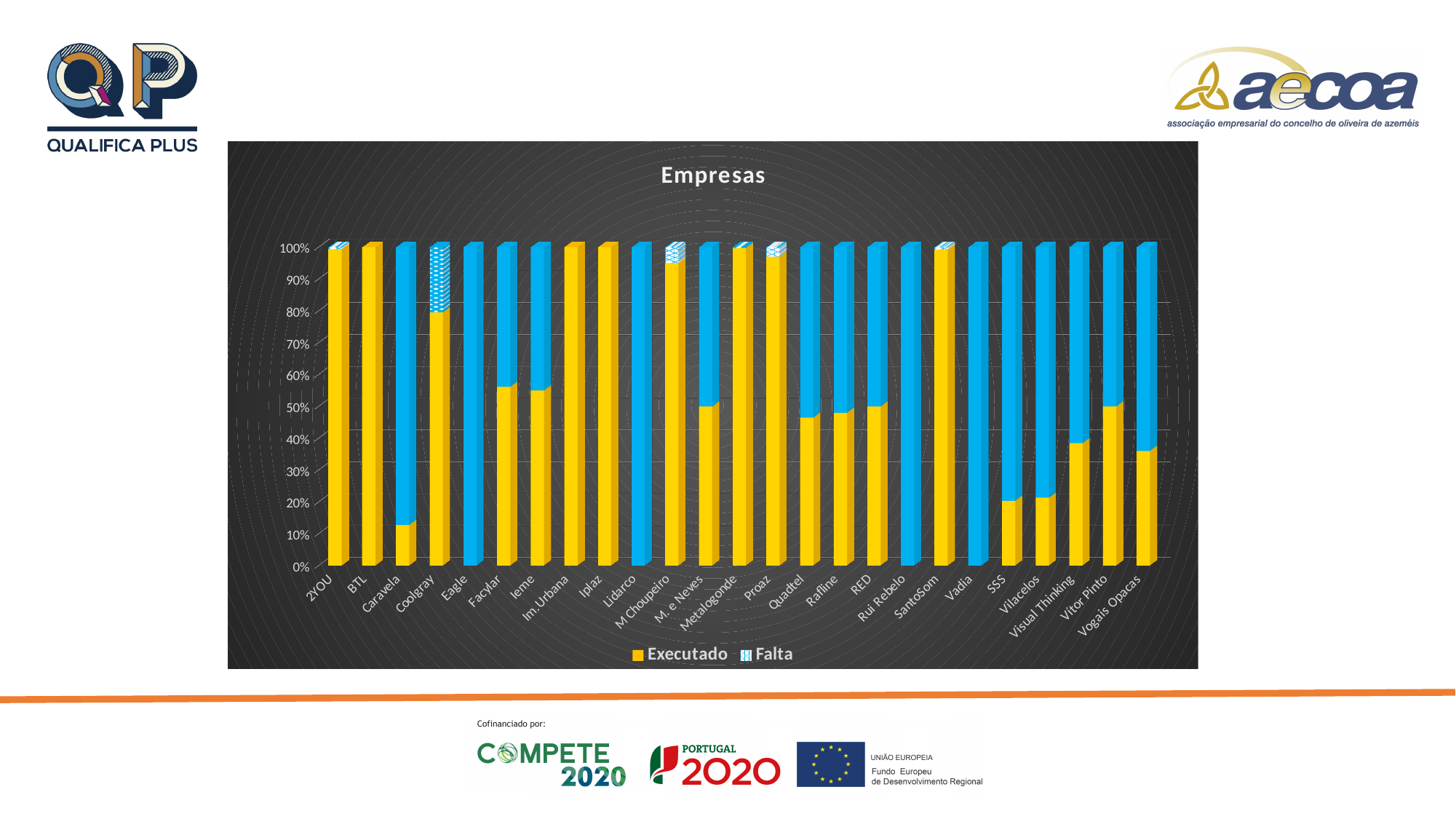
Is the Executado value for Coolgray greater or less than 70%? greater What kind of chart is shown on the slide? Stacked bar chart What is the title of the chart? Empresas Is the Executado value for M Choupeiro greater or less than 80%? greater Is the Executado value for Caravela greater or less than 20%? less Which has a larger Executado share, Coolgray or Caravela? Coolgray What are the two series named in the legend? Executado and Falta How many companies (categories) are shown on the x axis? 25 Which has a larger Executado share, Vogais Opacas or Vilacelos? Vogais Opacas How many series does the chart's legend list? 2